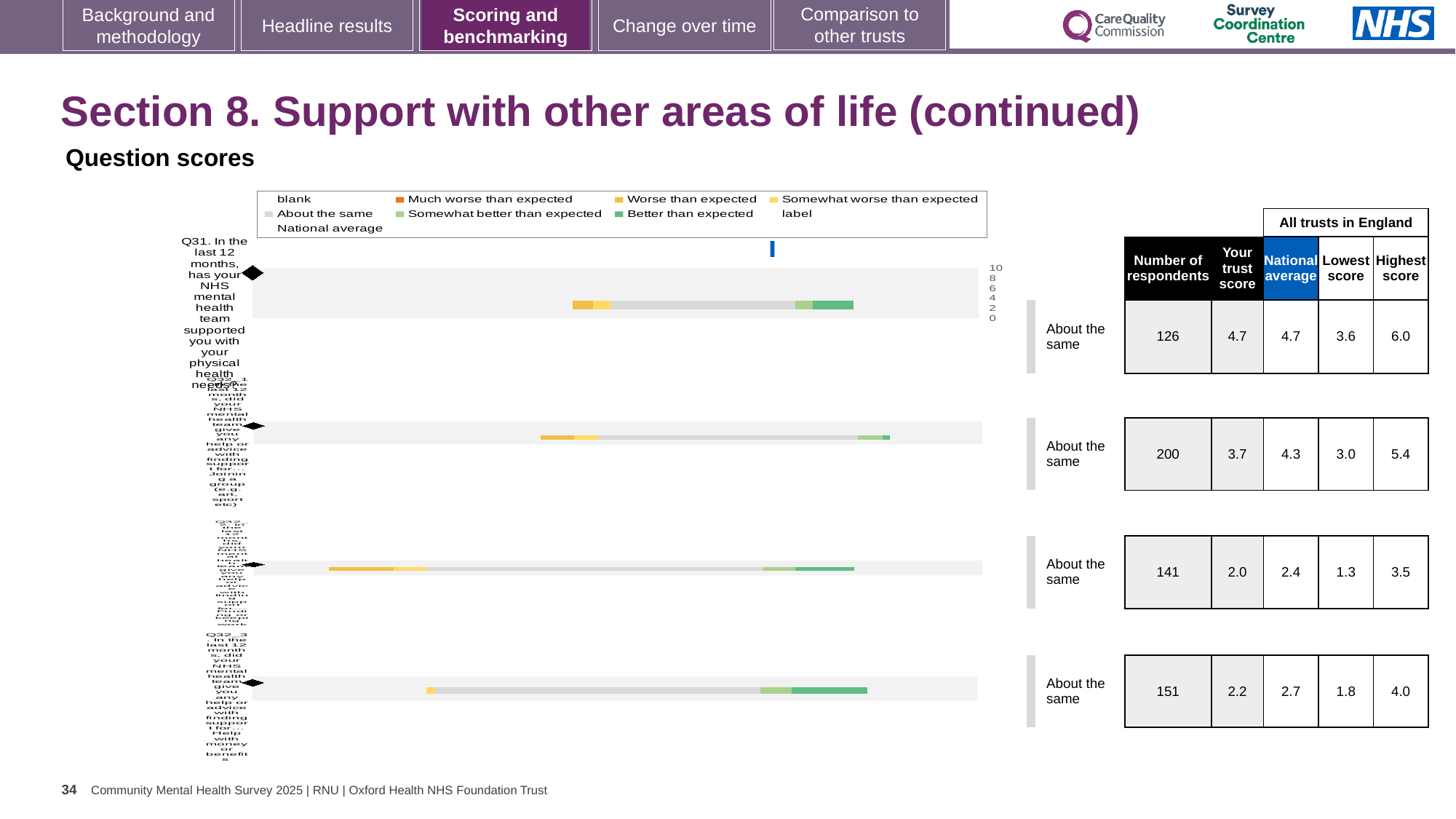
What is the trust score for Q31 (support with physical health needs)? 4.7 What is the lowest score across all trusts in England for Q31? 3.6 What kind of chart is shown on the slide? bar chart What is the highest score across all trusts in England for Q31? 6.0 What is the lowest 'Your trust score' value shown in the table? 2.0 How many question rows (bars) does the chart show? 4 What colour does the legend use for 'Better than expected'? green What is the difference between the highest and lowest scores for Q31? 2.4 What benchmark category is shown for Q31? About the same What is the largest number of respondents shown in the table? 200 How many respondents are listed for Q31 (support with physical health needs)? 126 What colour does the legend use for 'Much worse than expected'? orange